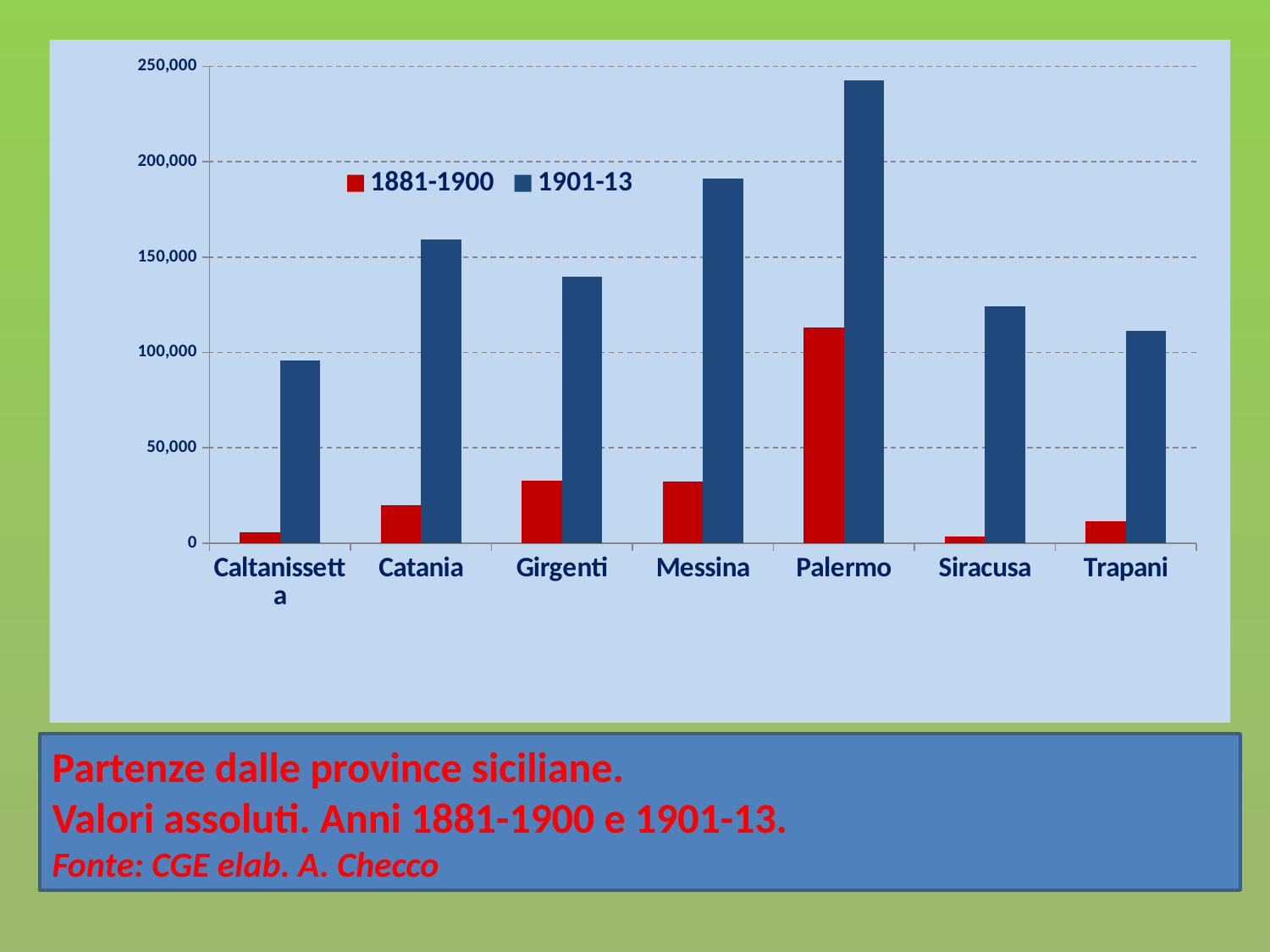
For 1901-13, which is larger: Catania or Girgenti? Catania Which province has the lowest value for 1901-13? Caltanissetta Which colour represents the 1881-1900 series? red Is the value for Palermo in 1901-13 greater or less than 200,000? greater Which province has the highest value for 1881-1900? Palermo Which province has the highest value for 1901-13? Palermo How many provinces are shown on the x axis? 7 Is the value for Palermo in 1881-1900 greater or less than 100,000? greater Is the value for Caltanissetta in 1901-13 greater or less than 100,000? less How many series does the legend list? 2 What kind of chart is shown on the slide? bar chart